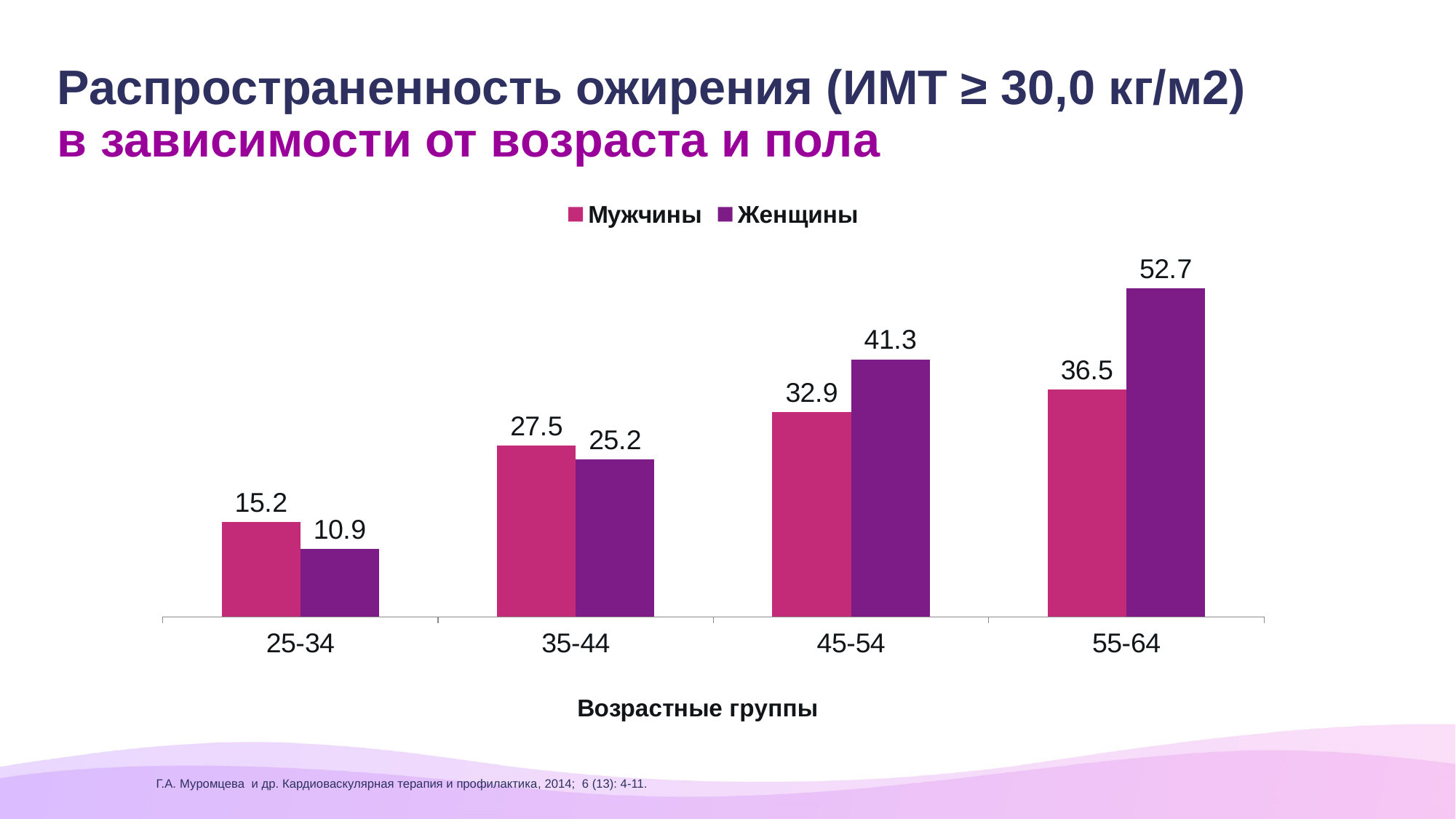
In the 35-44 age group, which is larger: Мужчины or Женщины? Мужчины Which age group has the highest value for Женщины? 55-64 What kind of chart is shown on the slide? Bar chart What is the value for Женщины in the 55-64 age group? 52.7 In the 45-54 age group, which is larger: Мужчины or Женщины? Женщины What is the difference between Женщины and Мужчины in the 55-64 age group? 16.2 How many age groups are shown on the x axis? 4 Do the values for Женщины rise or fall as age group increases along the x axis? Rise What is the value for Женщины in the 35-44 age group? 25.2 Which age group has the lowest value for Мужчины? 25-34 What is the value for Мужчины in the 25-34 age group? 15.2 How many series does the legend list? 2